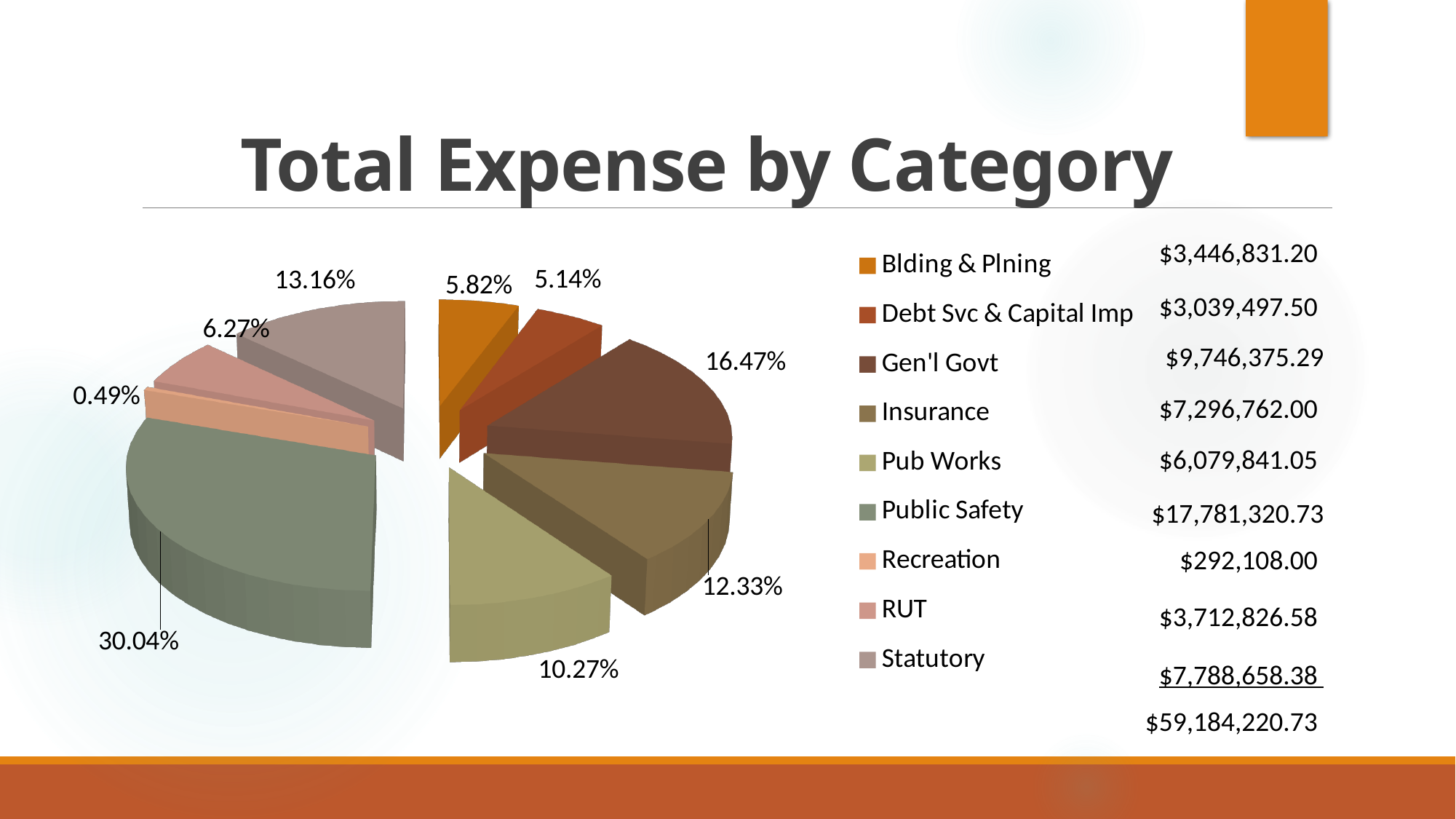
What share of the pie does Recreation represent? 0.49% What share of the pie does Statutory represent? 13.16% Which category has the smallest slice of the pie? Recreation Which slice is larger, Insurance or Pub Works? Insurance How many categories does the legend list? 9 Which category has the largest slice of the pie? Public Safety What share of the pie does Gen'l Govt represent? 16.47% What is the difference in percentage points between the Public Safety slice and the Statutory slice? 16.88 What type of chart is shown on the slide? pie chart What is the title of the chart? Total Expense by Category How many slices does the pie chart have? 9